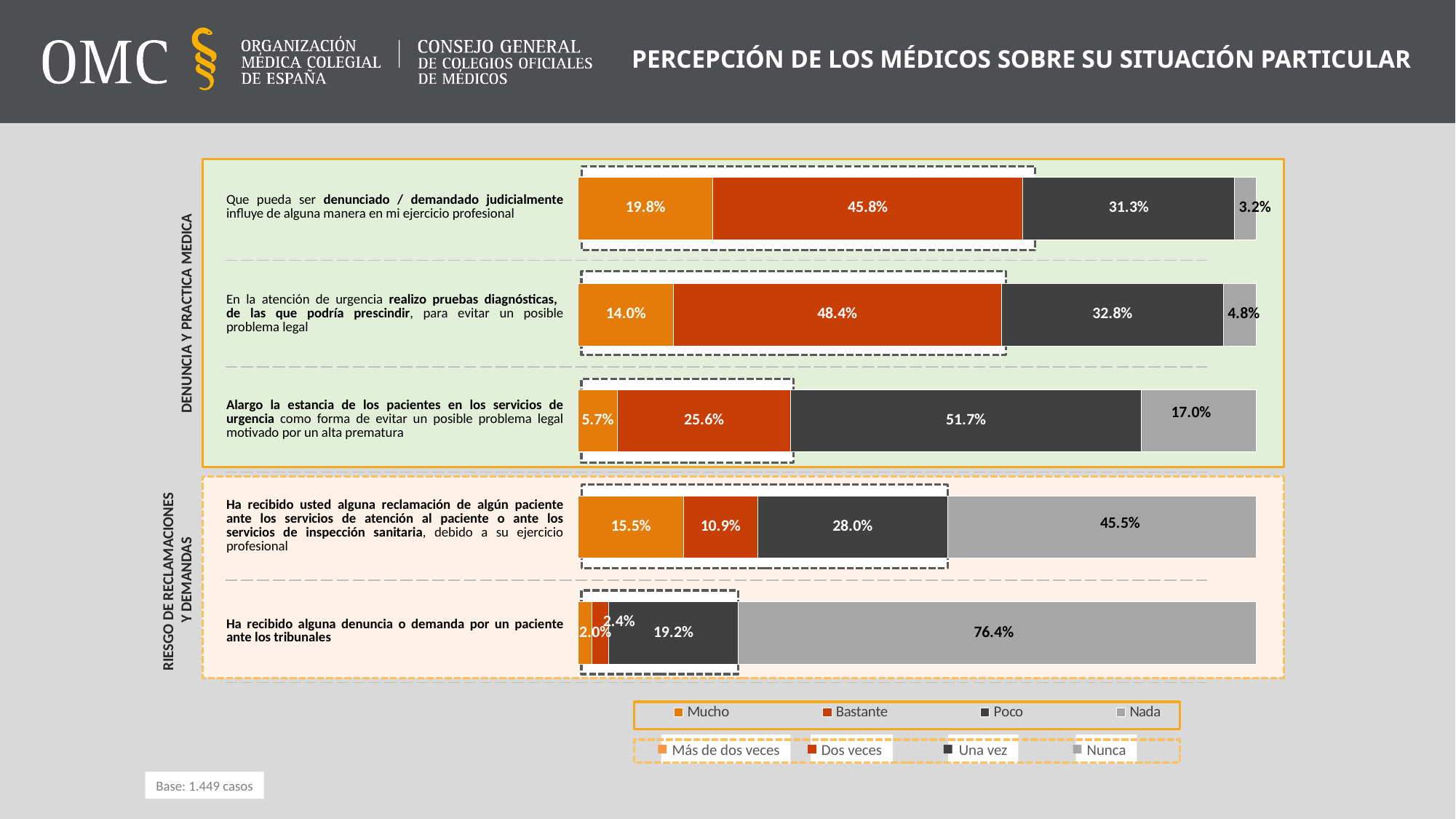
How many series does the legend for the 'Denuncia y practica medica' chart list? 4 In the 'Denuncia y practica medica' chart, what is the 'Bastante' value for 'Que pueda ser denunciado / demandado judicialmente influye de alguna manera en mi ejercicio profesional'? 45.8% In the 'Denuncia y practica medica' chart, which is larger for 'Que pueda ser denunciado / demandado judicialmente': the 'Mucho' value or the 'Poco' value? Poco In the 'Riesgo de reclamaciones y demandas' chart, what is the 'Nunca' value for 'Ha recibido alguna denuncia o demanda por un paciente ante los tribunales'? 76.4% In the 'Denuncia y practica medica' chart, what is the 'Nada' value for 'Alargo la estancia de los pacientes en los servicios de urgencia'? 17.0% In the 'Denuncia y practica medica' chart, which statement has the highest 'Poco' value? Alargo la estancia de los pacientes en los servicios de urgencia In the 'Denuncia y practica medica' chart, what is the 'Mucho' value for 'En la atención de urgencia realizo pruebas diagnósticas, de las que podría prescindir'? 14.0% In the 'Denuncia y practica medica' chart, which statement has the lowest 'Mucho' value? Alargo la estancia de los pacientes en los servicios de urgencia In the 'Riesgo de reclamaciones y demandas' chart, what is the 'Una vez' value for 'Ha recibido usted alguna reclamación de algún paciente ante los servicios de atención al paciente'? 28.0% In the 'Riesgo de reclamaciones y demandas' chart, what is the difference between the 'Nunca' and 'Una vez' values for 'Ha recibido alguna denuncia o demanda por un paciente ante los tribunales'? 57.2% What type of chart is shown on the slide? Stacked bar chart How many statements (bars) are plotted in the 'Riesgo de reclamaciones y demandas' chart? 2